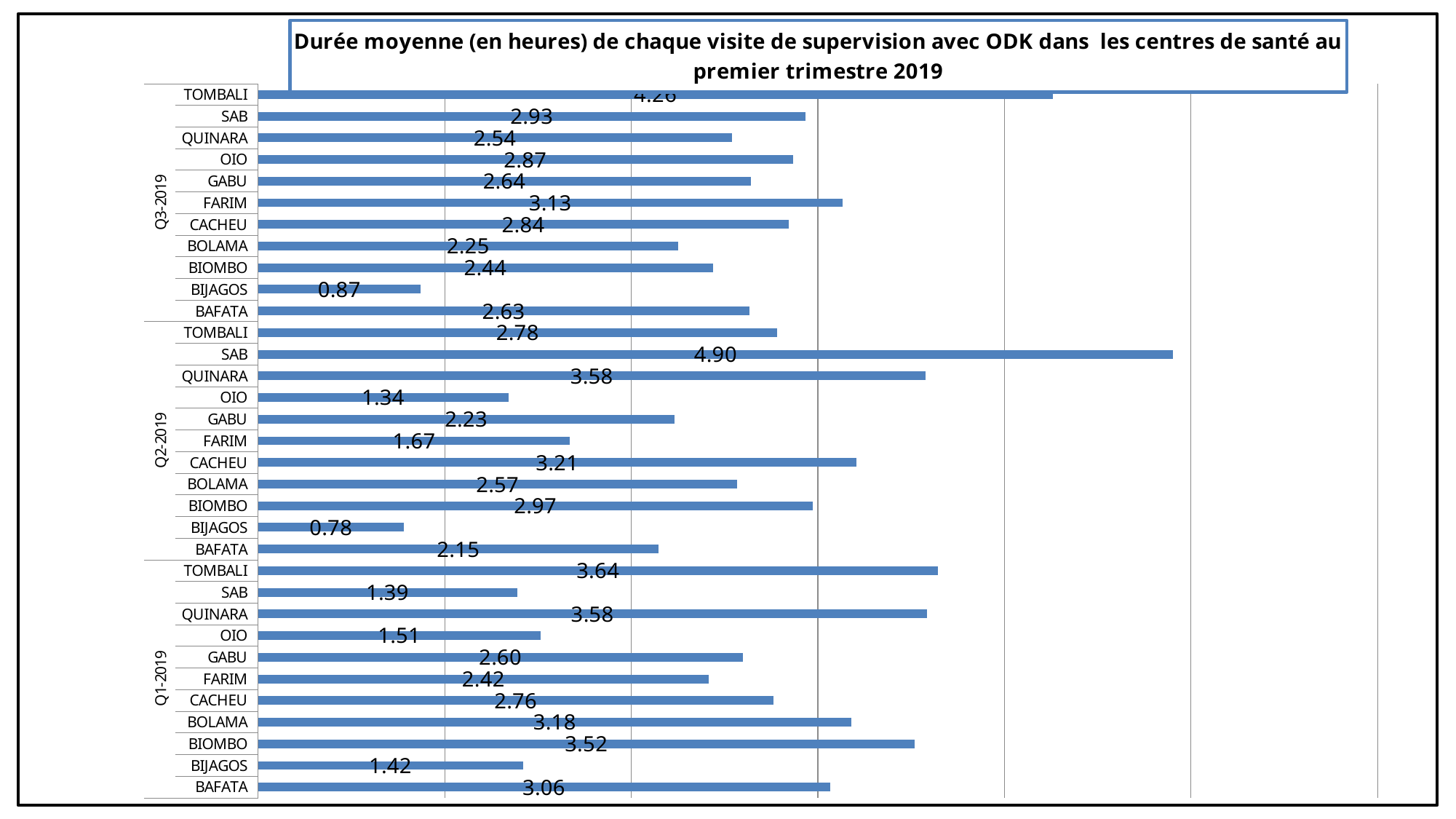
What is the value for SAB in Q2-2019? 4.90 Which is larger: the value for BIOMBO in Q1-2019 or the value for BIOMBO in Q2-2019? BIOMBO in Q1-2019 What is the difference between the values for QUINARA in Q2-2019 and OIO in Q2-2019? 2.24 Which bar has the highest value on the chart? SAB (Q2-2019) What kind of chart is shown on the slide? Bar chart How many bars are plotted on the chart in total? 33 What is the value for FARIM in Q3-2019? 3.13 What is the value for OIO in Q2-2019? 1.34 What is the value for BIJAGOS in Q1-2019? 1.42 Which three quarter groups are shown on the vertical axis? Q3-2019, Q2-2019, Q1-2019 Which bar has the lowest value on the chart? BIJAGOS (Q2-2019) Within Q1-2019, which region has the lowest value? SAB